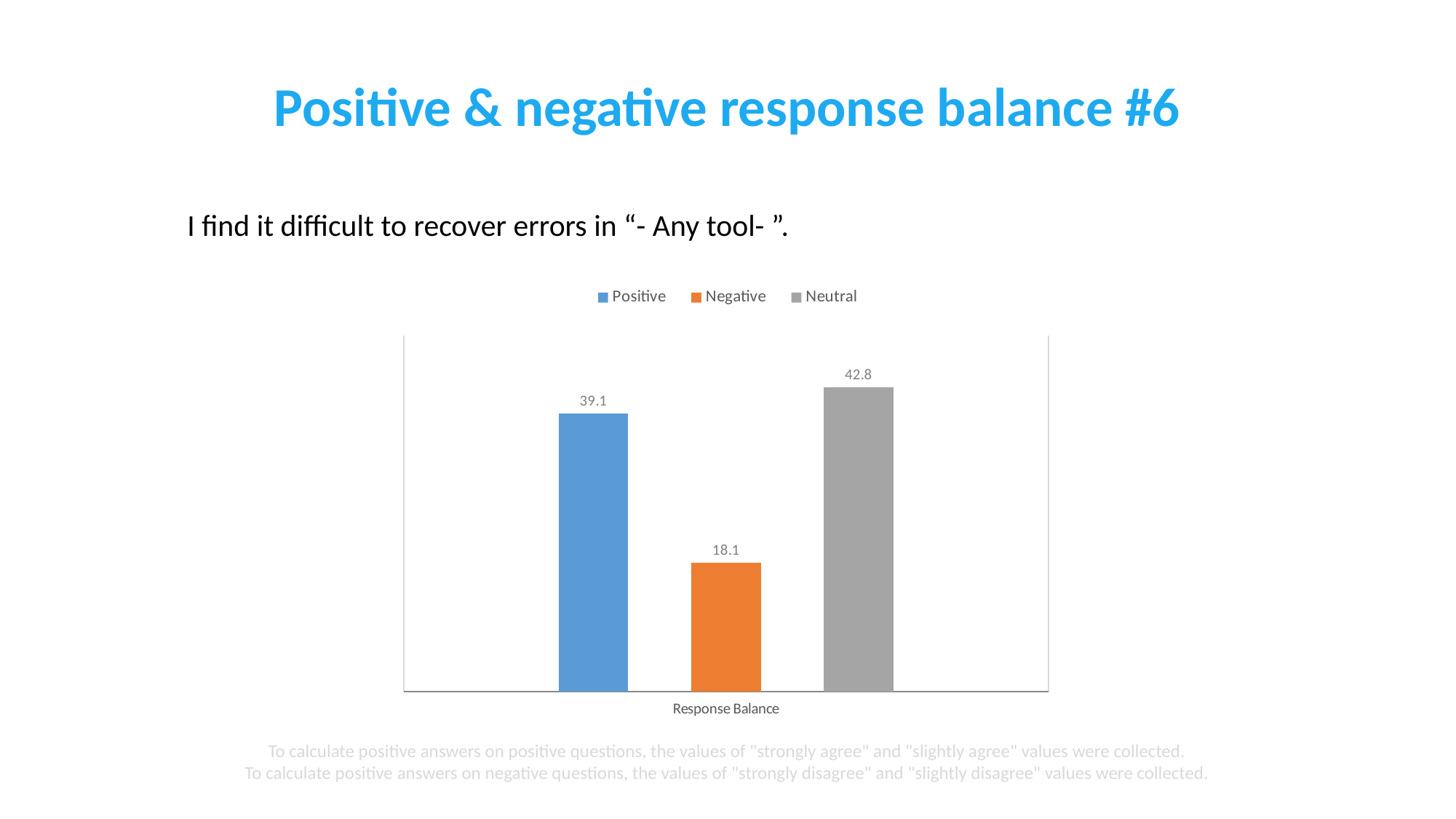
What is the difference between the Positive and Negative values? 21 What is the value of the Negative series? 18.1 Which is larger, the Positive value or the Negative value? Positive Which series has the lowest value? Negative Which series has the highest value? Neutral What kind of chart is shown on the slide? Bar chart What is the value of the Positive series? 39.1 What colour is the Negative bar? Orange What is the value of the Neutral series? 42.8 How many series does the legend list? 3 What is the category label on the x axis? Response Balance What is the difference between the Neutral and Positive values? 3.7